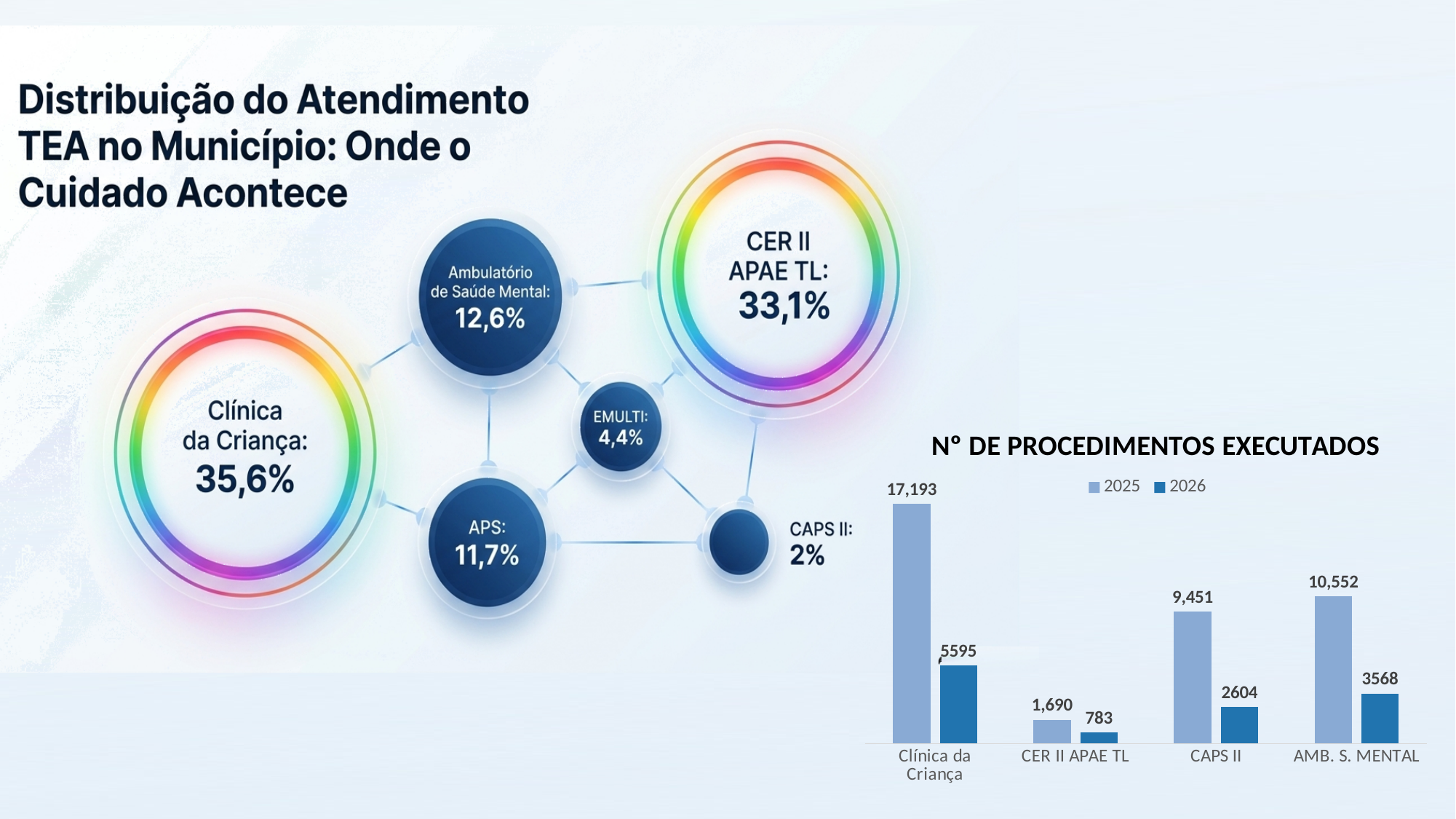
In the bar chart titled 'N° DE PROCEDIMENTOS EXECUTADOS', what is the 2026 value for CAPS II? 2604 How many categories are shown on the x axis of the bar chart titled 'N° DE PROCEDIMENTOS EXECUTADOS'? 4 In the bar chart titled 'N° DE PROCEDIMENTOS EXECUTADOS', which category has the highest 2025 value? Clínica da Criança In the bar chart titled 'N° DE PROCEDIMENTOS EXECUTADOS', which category has the lowest 2026 value? CER II APAE TL How many series does the legend of the bar chart titled 'N° DE PROCEDIMENTOS EXECUTADOS' list? 2 In the bar chart titled 'N° DE PROCEDIMENTOS EXECUTADOS', what is the 2026 value for AMB. S. MENTAL? 3568 In the bar chart titled 'N° DE PROCEDIMENTOS EXECUTADOS', what is the 2025 value for Clínica da Criança? 17,193 In the bar chart titled 'N° DE PROCEDIMENTOS EXECUTADOS', which is larger: the 2025 value for CAPS II or the 2025 value for AMB. S. MENTAL? AMB. S. MENTAL In the bubble diagram on the left of the slide, what percentage is shown for CER II APAE TL? 33,1% What kind of chart is the one titled 'N° DE PROCEDIMENTOS EXECUTADOS'? Bar chart In the bar chart titled 'N° DE PROCEDIMENTOS EXECUTADOS', what is the difference between the 2025 and 2026 values for CER II APAE TL? 907 In the bubble diagram on the left of the slide, which service has the largest share? Clínica da Criança